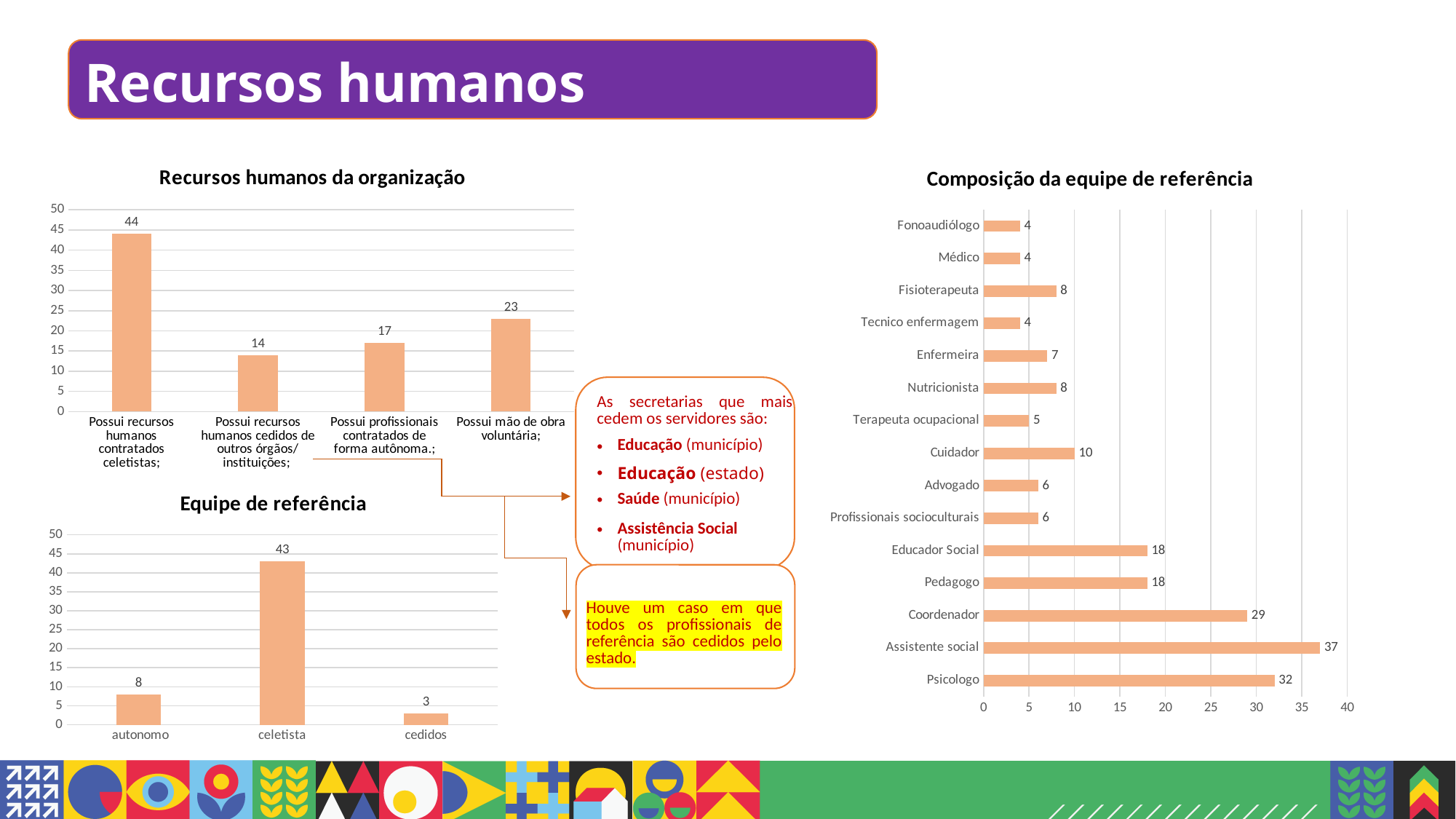
In the 'Equipe de referência' chart, what is the value for 'celetista'? 43 In the 'Equipe de referência' chart, which category has the lowest value? cedidos In the 'Recursos humanos da organização' chart, what is the difference between 'Possui recursos humanos contratados celetistas' and 'Possui recursos humanos cedidos de outros órgãos/instituições'? 30 In the 'Composição da equipe de referência' chart, which category has the highest value? Assistente social In the 'Recursos humanos da organização' chart, what is the value for 'Possui mão de obra voluntária'? 23 How many categories are shown in the 'Composição da equipe de referência' chart? 15 In the 'Recursos humanos da organização' chart, which category has the highest value? Possui recursos humanos contratados celetistas In the 'Composição da equipe de referência' chart, what is the value for 'Coordenador'? 29 In the 'Composição da equipe de referência' chart, which is larger: 'Psicologo' or 'Coordenador'? Psicologo How many categories are shown in the 'Recursos humanos da organização' chart? 4 What type of chart is the 'Equipe de referência' chart? Bar chart In the 'Composição da equipe de referência' chart, what is the difference between 'Assistente social' and 'Psicologo'? 5